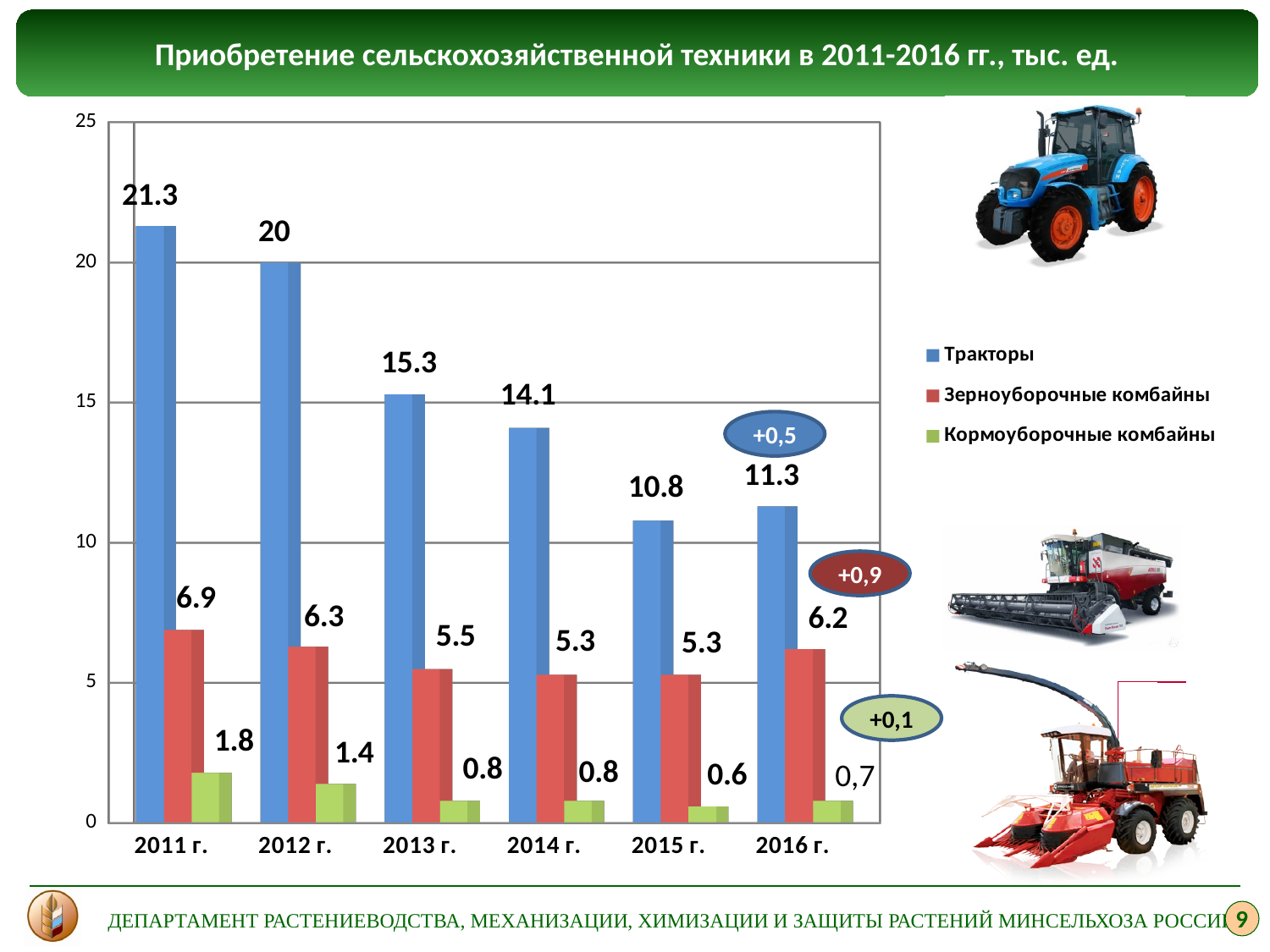
What is the difference between the Тракторы values for 2011 г. and 2012 г.? 1.3 Is the value for Тракторы in 2014 г. greater or less than 15? less What is the value for Кормоуборочные комбайны in 2016 г.? 0,7 What kind of chart is shown on the slide? bar chart What is the value for Тракторы in 2011 г.? 21.3 In which year is the value for Тракторы the highest? 2011 г. How many series does the legend list? 3 In which year is the value for Кормоуборочные комбайны the lowest? 2015 г. What is the value for Зерноуборочные комбайны in 2013 г.? 5.5 Which is larger: the Зерноуборочные комбайны value in 2012 г. or in 2016 г.? 2012 г. Do the Тракторы values rise or fall from 2011 г. to 2015 г.? fall How many years are shown on the x axis? 6